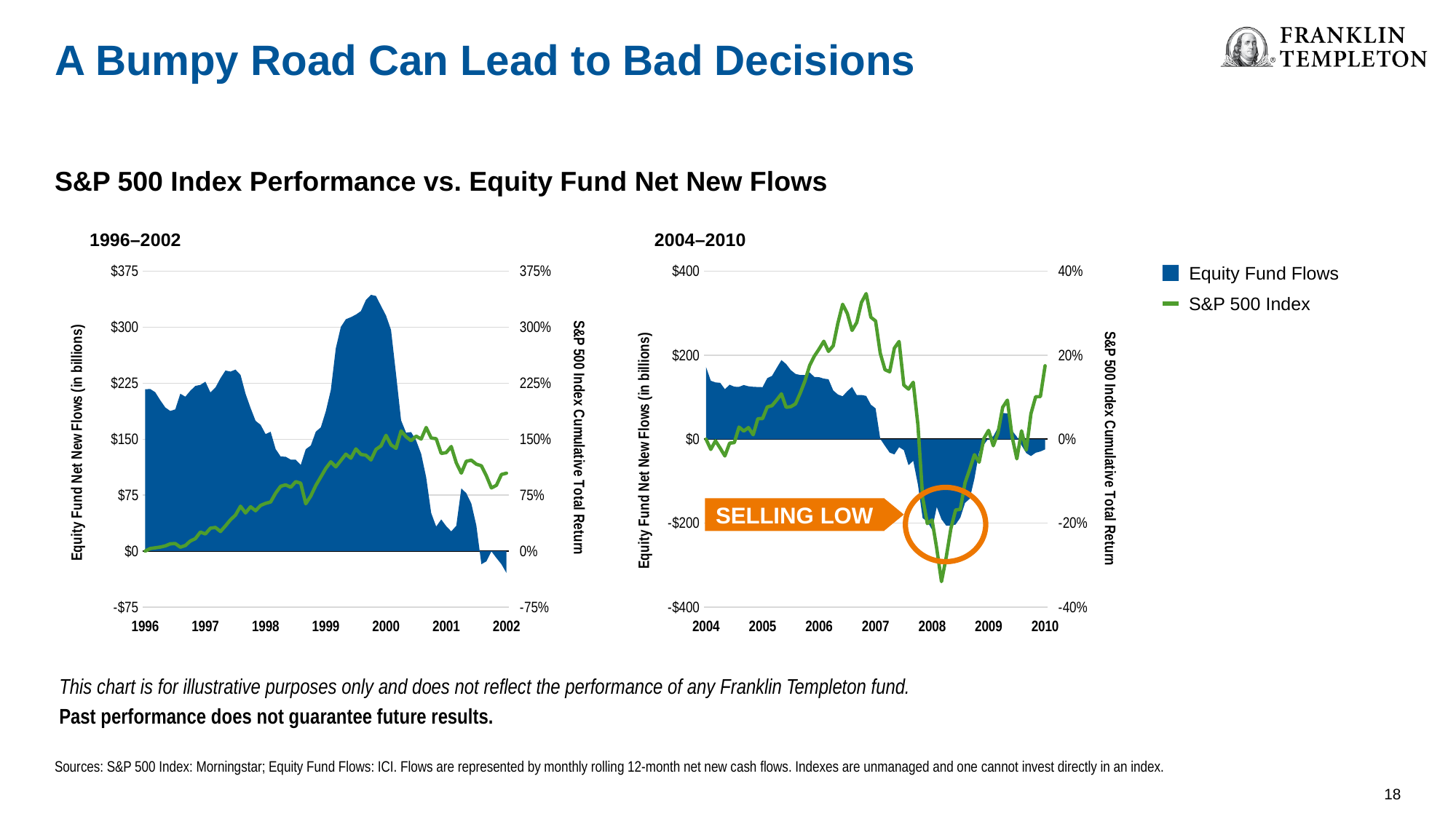
In the 1996–2002 chart, does the S&P 500 Index cumulative total return rise or fall from 1996 to 2000? rise How many series does the legend list? 2 In the 1996–2002 chart, is the S&P 500 Index cumulative total return at the end of 2002 greater or less than 75%? greater In the 1996–2002 chart, how many year labels are shown on the x axis? 7 What is the title shown above the two charts? S&P 500 Index Performance vs. Equity Fund Net New Flows In the 1996–2002 chart, what kind of chart is used to show the Equity Fund Flows series? Area chart What are the two series named in the legend? Equity Fund Flows and S&P 500 Index In the 1996–2002 chart, is the peak value of Equity Fund Flows around 2000 greater or less than $300? greater In the 2004–2010 chart, what kind of chart is used to show the S&P 500 Index series? Line chart In the 2004–2010 chart, is the peak value of the S&P 500 Index cumulative total return in 2007 greater or less than 20%? greater In the 2004–2010 chart, how many year labels are shown on the x axis? 7